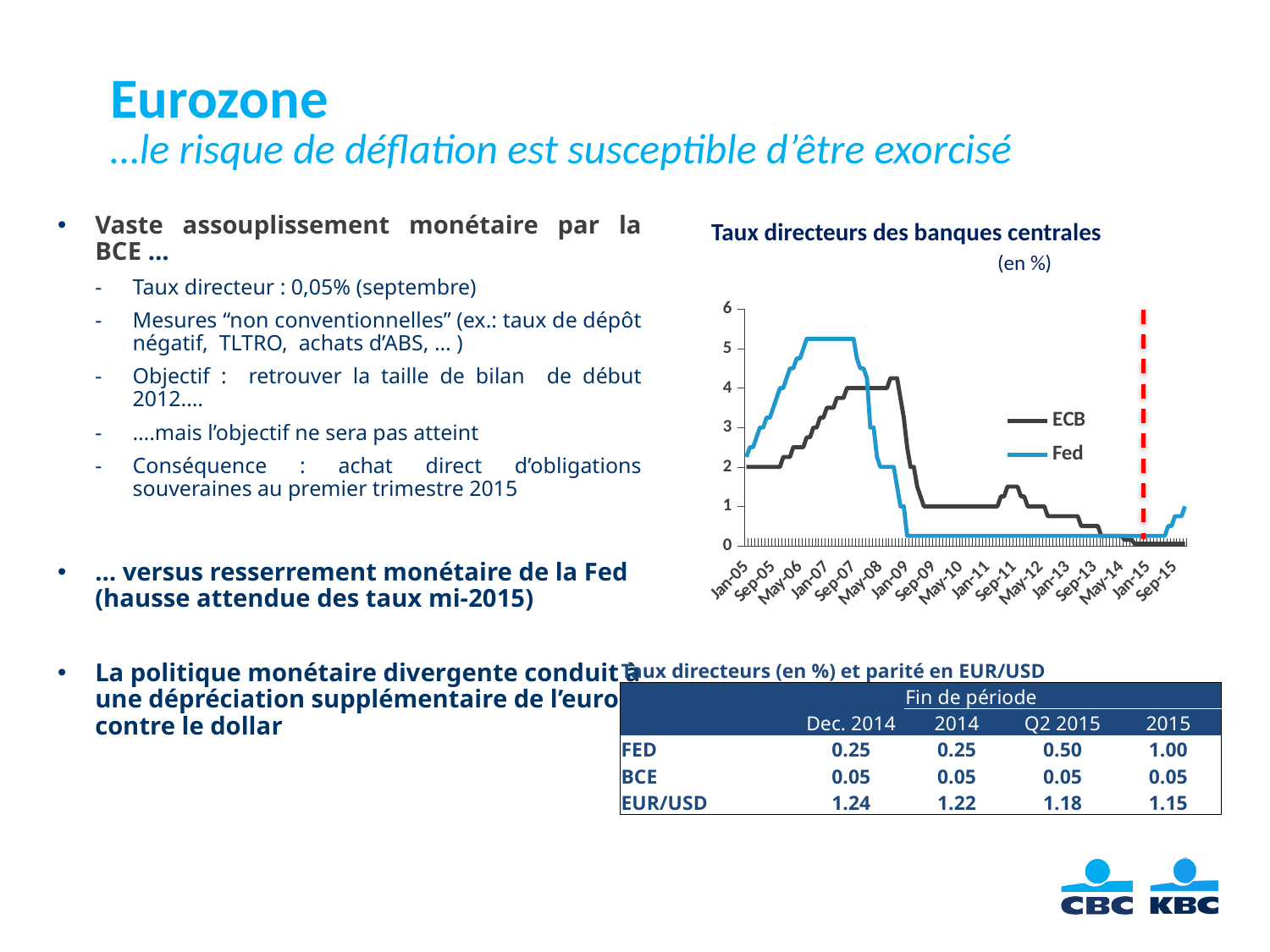
Which series reaches the highest value on the chart, ECB or Fed? Fed Does the ECB series rise or fall between Jan-09 and Sep-09? fall What is the title of the chart? Taux directeurs des banques centrales Is the value of the Fed series around May-10 greater or less than 1? less Does the Fed series rise or fall between Jan-05 and Sep-07? rise Is the peak value of the ECB series greater or less than 4? greater What kind of chart is shown on the slide? line chart Around Sep-07, which series has the higher value, ECB or Fed? Fed How many series does the chart legend list? 2 What are the two series named in the chart legend? ECB and Fed Is the peak value of the Fed series greater or less than 5? greater Around Jan-13, which series has the higher value, ECB or Fed? ECB